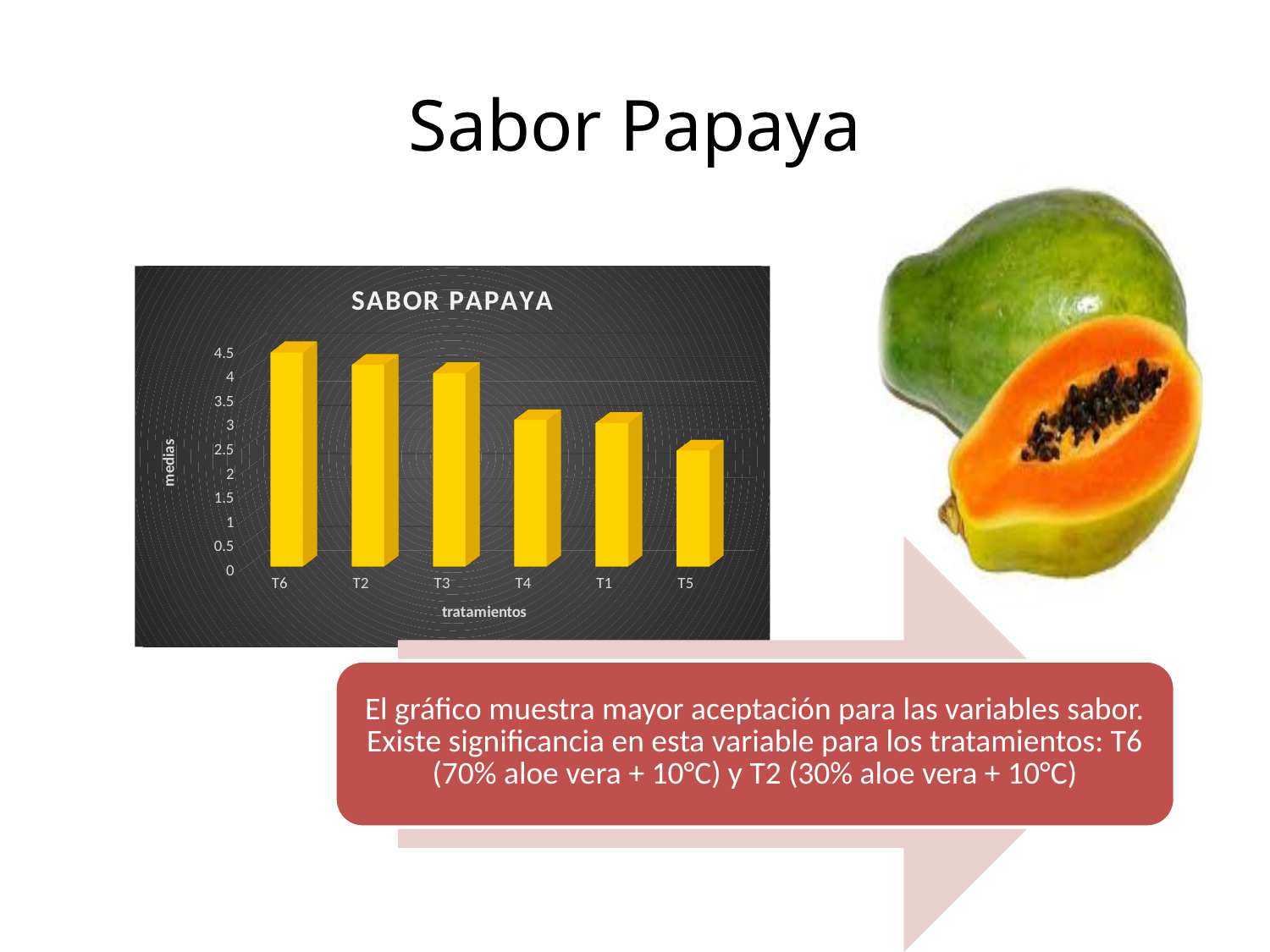
Is the value for T5 greater or less than 3? less How many treatments (categories) are plotted on the x axis? 6 Is the value for T3 greater or less than 3.5? greater Is the value for T6 greater or less than 4? greater What kind of chart is shown on the slide? bar chart Do the values rise or fall moving from left to right along the x axis? fall Which treatment has the highest value? T6 Which treatment has the lowest value? T5 What is the title of the chart? SABOR PAPAYA Which has a larger value, T3 or T4? T3 What is the label of the vertical axis? medias